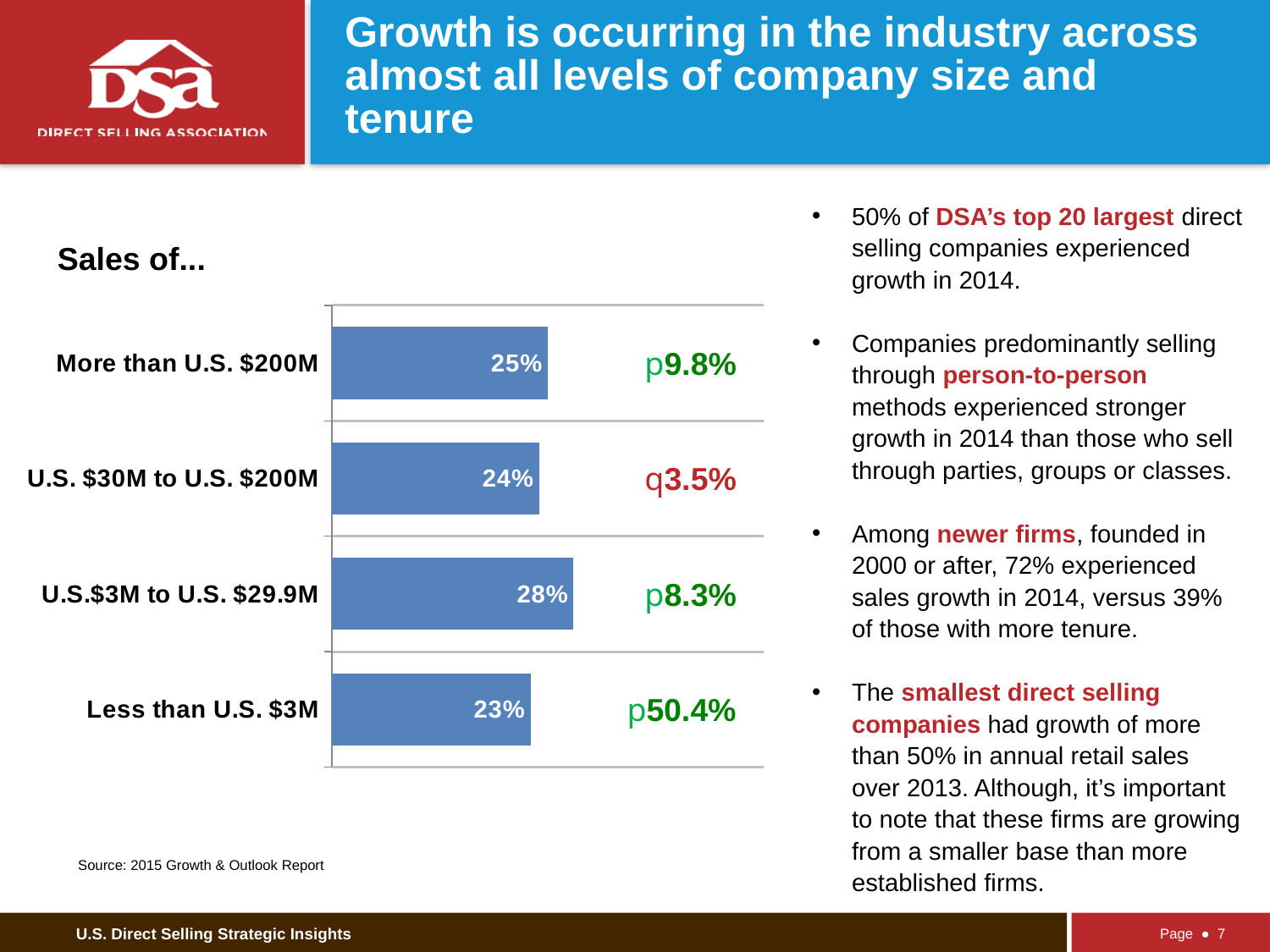
What is the difference between the bar values for "U.S.$3M to U.S. $29.9M" and "Less than U.S. $3M"? 5% What is the value of the bar for "More than U.S. $200M"? 25% What is the value of the bar for "Less than U.S. $3M"? 23% What is the value of the bar for "U.S. $30M to U.S. $200M"? 24% What is the value of the bar for "U.S.$3M to U.S. $29.9M"? 28% What growth figure is printed next to the bar for "Less than U.S. $3M"? 50.4% How many sales categories are shown in the chart? 4 Which has a larger bar value: "More than U.S. $200M" or "Less than U.S. $3M"? More than U.S. $200M Which sales category has the lowest bar value? Less than U.S. $3M What type of chart is shown on the slide? Bar chart Which sales category has the highest bar value? U.S.$3M to U.S. $29.9M What is the title of the chart? Sales of...